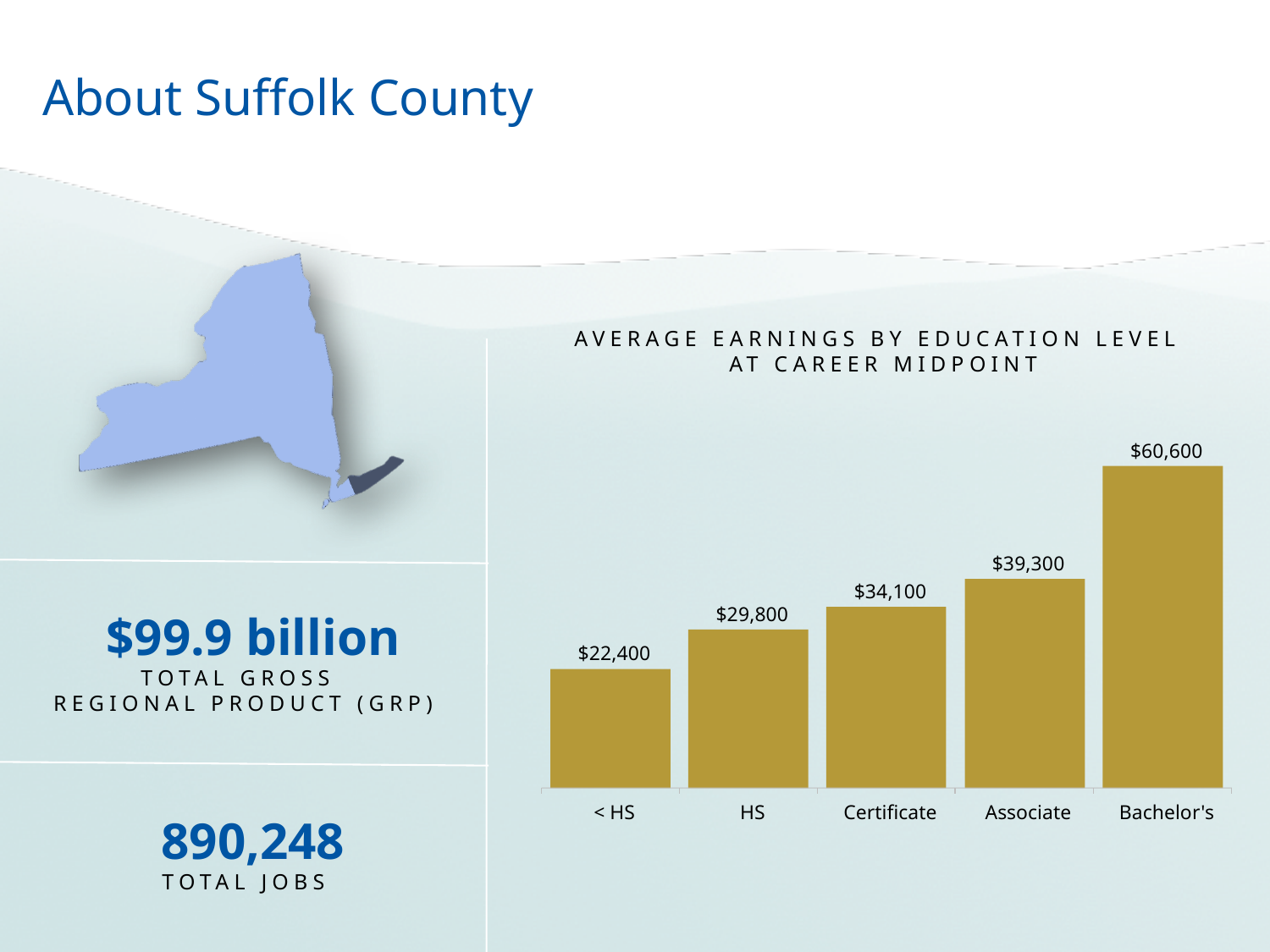
What is the difference in average earnings between the HS and < HS education levels? $7,400 Which education level has the highest average earnings at career midpoint? Bachelor's Which education level has the lowest average earnings at career midpoint? < HS What kind of chart is used to show average earnings by education level? Bar chart What are the average earnings at career midpoint for the Certificate education level? $34,100 Which has higher average earnings at career midpoint, Associate or Certificate? Associate What is the difference in average earnings between the Bachelor's and Associate education levels? $21,300 What is the title of the chart on the slide? Average Earnings by Education Level at Career Midpoint What are the average earnings at career midpoint for the Bachelor's education level? $60,600 Do average earnings rise or fall as education level increases from < HS to Bachelor's? Rise How many education levels are shown in the chart? 5 What are the average earnings at career midpoint for the < HS education level? $22,400